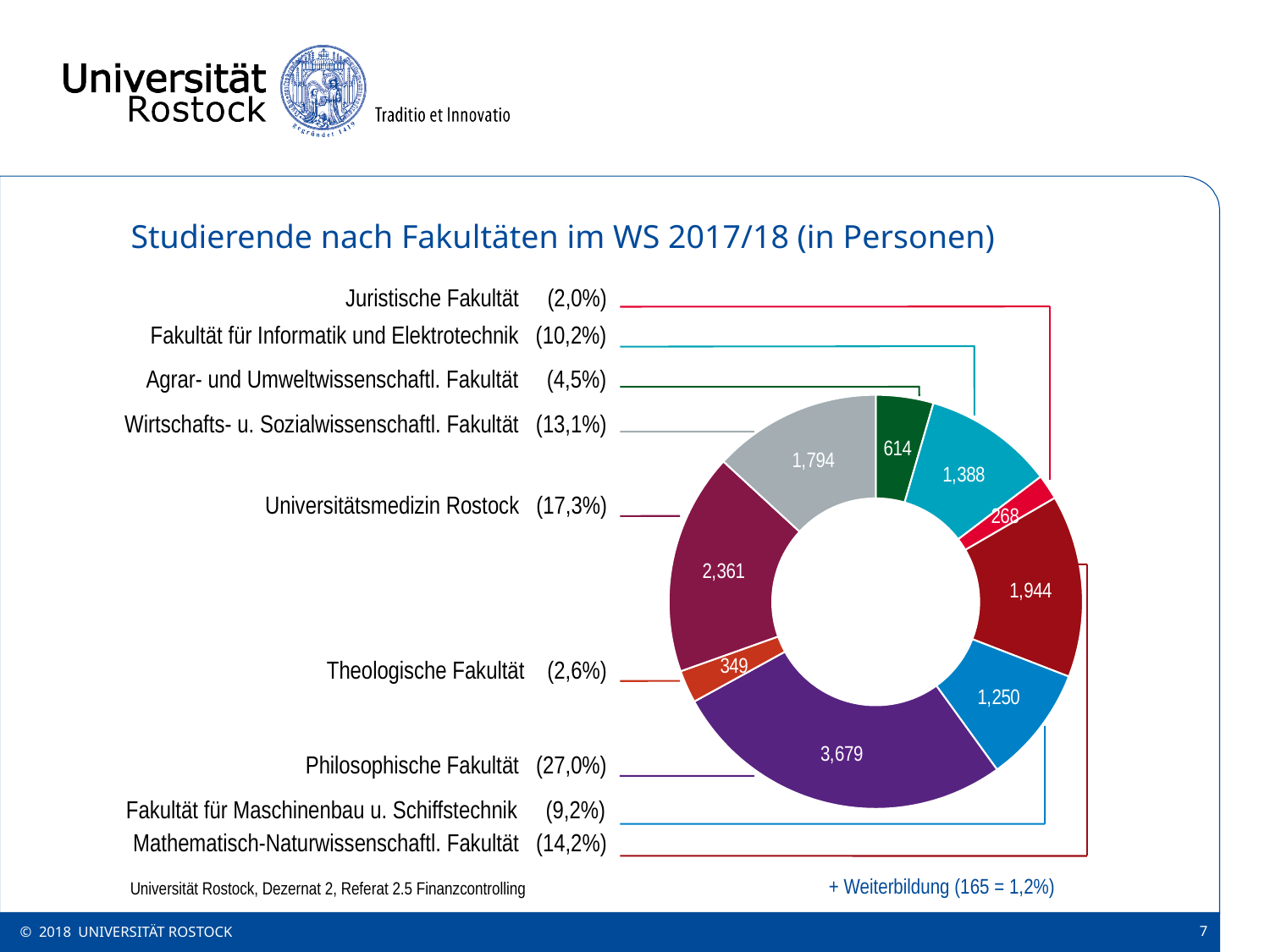
How many faculties (slices) are shown in the chart? 9 What share of students does the Theologische Fakultät have? 2,6% How many students does the Philosophische Fakultät have? 3,679 What kind of chart is shown on the slide? Pie chart (donut) What is the difference in students between the Philosophische Fakultät and the Universitätsmedizin Rostock? 1,318 How many students does the Fakultät für Informatik und Elektrotechnik have? 1,388 What is the title of the chart? Studierende nach Fakultäten im WS 2017/18 (in Personen) What share of students does the Mathematisch-Naturwissenschaftl. Fakultät have? 14,2% Which has more students, the Wirtschafts- u. Sozialwissenschaftl. Fakultät or the Fakultät für Maschinenbau u. Schiffstechnik? Wirtschafts- u. Sozialwissenschaftl. Fakultät How many students does the Universitätsmedizin Rostock have? 2,361 Which faculty has the largest share of students? Philosophische Fakultät Which faculty has the smallest share of students? Juristische Fakultät